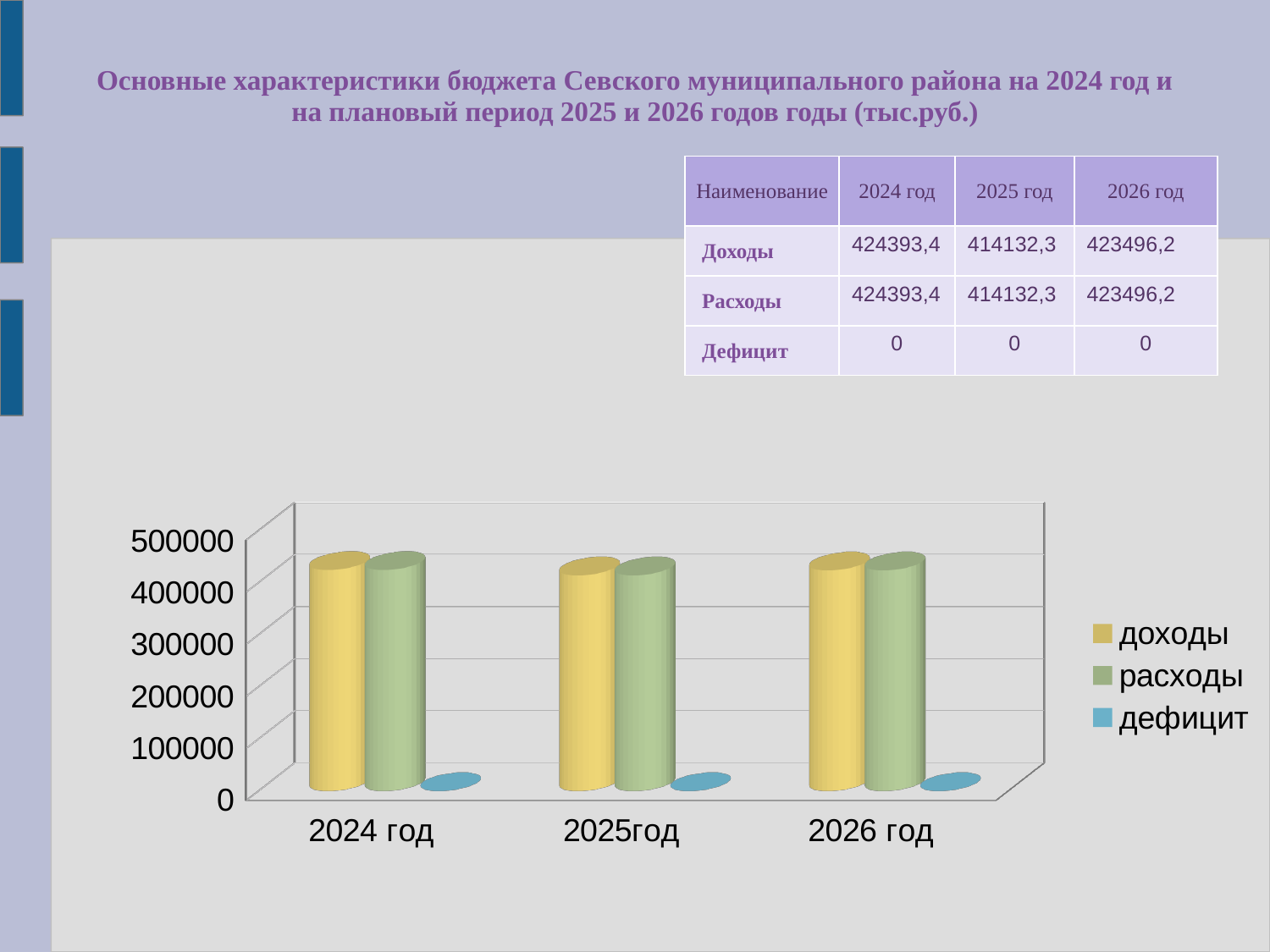
Which series is shown in blue in the chart legend? дефицит Which year has the lowest value of доходы? 2025 год How many year categories are shown on the x axis of the chart? 3 What is the difference between доходы for 2024 год and доходы for 2025 год? 10261,1 What kind of chart is shown on the slide? bar chart What is the value of доходы for 2026 год? 423496,2 What is the value of доходы for 2024 год? 424393,4 What is the value of дефицит for 2024 год? 0 How many series does the chart legend list? 3 Is the value of дефицит for 2026 год greater or less than 100000? less What is the value of расходы for 2025 год? 414132,3 Is the value of доходы for 2024 год greater or less than 400000? greater